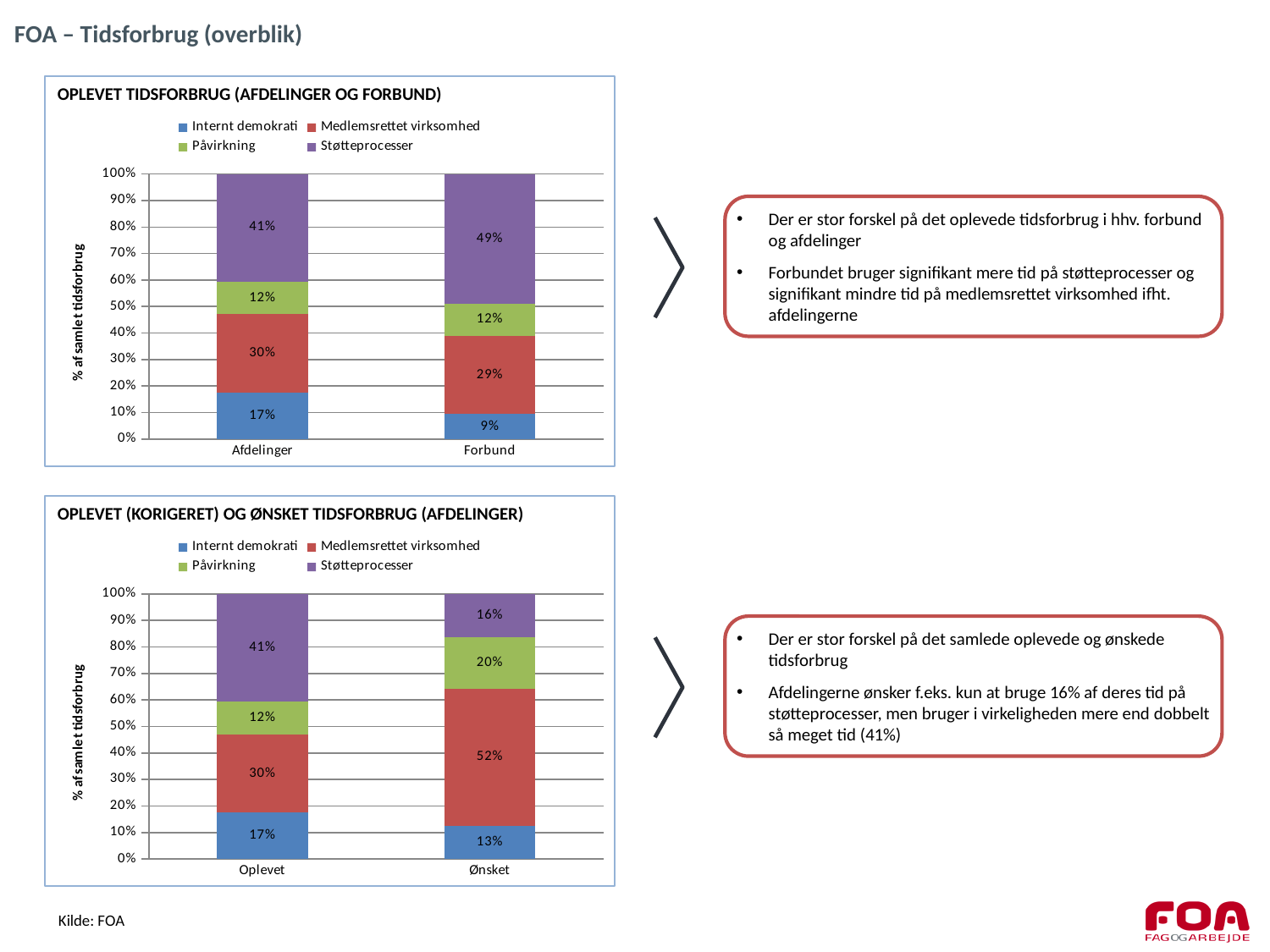
In the bottom chart (OPLEVET (KORIGERET) OG ØNSKET TIDSFORBRUG (AFDELINGER)), how many categories are shown on the x axis? 2 In the top chart (OPLEVET TIDSFORBRUG (AFDELINGER OG FORBUND)), how many series does the legend list? 4 In the top chart (OPLEVET TIDSFORBRUG (AFDELINGER OG FORBUND)), what is the value for Støtteprocesser for Forbund? 49% In the bottom chart (OPLEVET (KORIGERET) OG ØNSKET TIDSFORBRUG (AFDELINGER)), what is the value for Støtteprocesser for Ønsket? 16% What type of chart is the bottom chart (OPLEVET (KORIGERET) OG ØNSKET TIDSFORBRUG (AFDELINGER))? Stacked bar chart In the top chart (OPLEVET TIDSFORBRUG (AFDELINGER OG FORBUND)), what is the difference between the Støtteprocesser values for Forbund and Afdelinger? 8% In the top chart (OPLEVET TIDSFORBRUG (AFDELINGER OG FORBUND)), which has the larger Internt demokrati value, Afdelinger or Forbund? Afdelinger In the top chart (OPLEVET TIDSFORBRUG (AFDELINGER OG FORBUND)), which series has the largest share for Forbund? Støtteprocesser In the bottom chart (OPLEVET (KORIGERET) OG ØNSKET TIDSFORBRUG (AFDELINGER)), what is the value for Medlemsrettet virksomhed for Ønsket? 52% In the bottom chart (OPLEVET (KORIGERET) OG ØNSKET TIDSFORBRUG (AFDELINGER)), which series has the smallest share for Ønsket? Internt demokrati In the top chart (OPLEVET TIDSFORBRUG (AFDELINGER OG FORBUND)), what is the value for Internt demokrati for Afdelinger? 17% In the bottom chart (OPLEVET (KORIGERET) OG ØNSKET TIDSFORBRUG (AFDELINGER)), what is the difference between the Støtteprocesser values for Oplevet and Ønsket? 25%